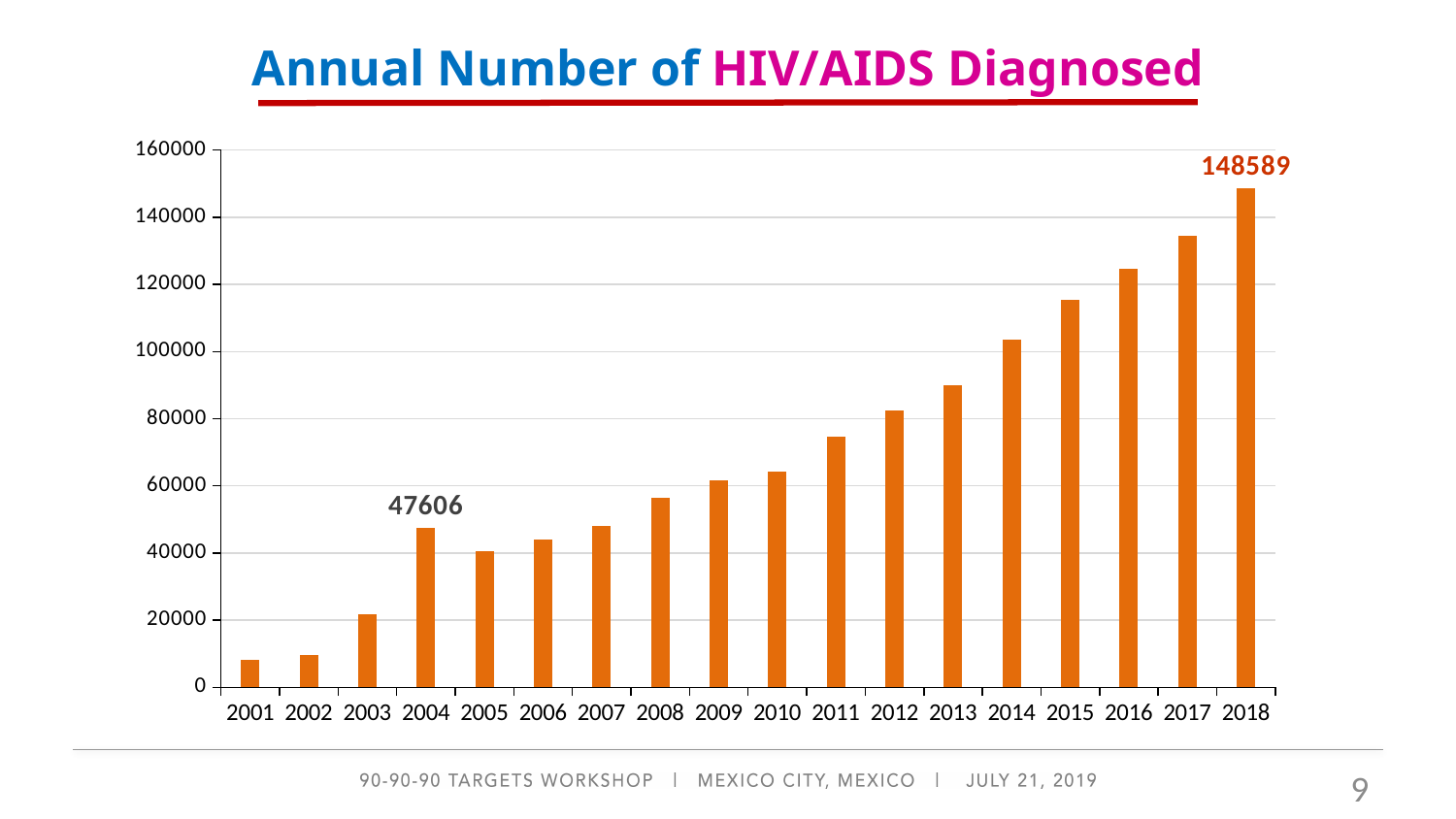
How many years are shown on the x axis? 18 What is the value for 2018? 148589 What is the value for 2004? 47606 What kind of chart is this? bar chart Which is larger, the value for 2004 or the value for 2005? 2004 Which year has the lowest value? 2001 What is the title of the chart? Annual Number of HIV/AIDS Diagnosed Is the value for 2014 greater or less than 100000? greater Is the value for 2003 greater or less than 40000? less Do the values generally rise or fall from 2001 to 2018? rise Which year has the highest value? 2018 What is the difference between the values for 2018 and 2004? 100983